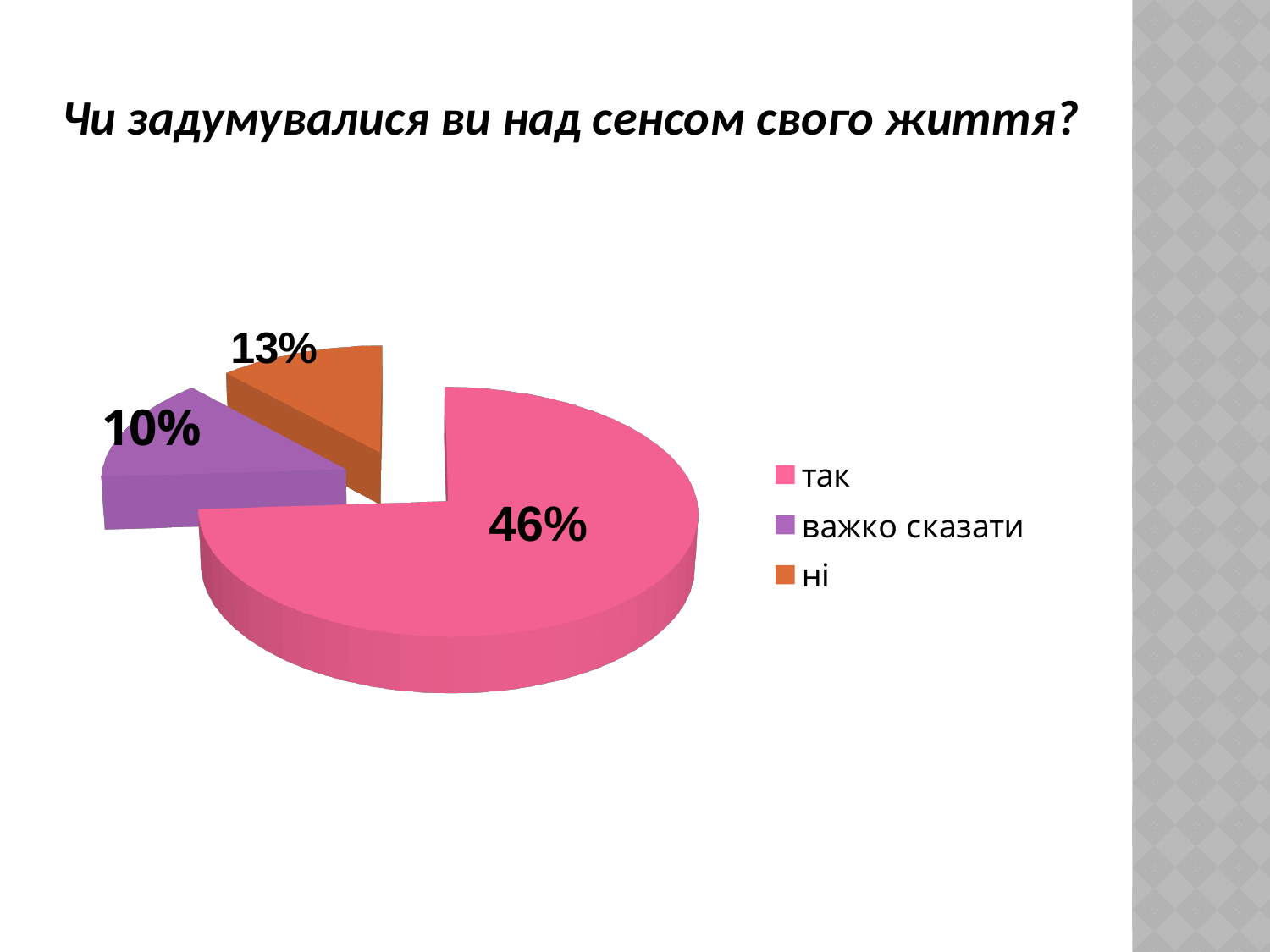
What colour is the "так" slice? pink What percentage is shown for the "так" slice? 46% How many slices does the pie chart have? 3 What percentage is shown for the "ні" slice? 13% Which category has the largest slice of the pie? так What percentage is shown for the "важко сказати" slice? 10% What kind of chart is shown on the slide? pie chart What is the difference between the "ні" and "важко сказати" percentages? 3% What is the difference between the "так" and "ні" percentages? 33% What is the title of the chart? Чи задумувалися ви над сенсом свого життя?